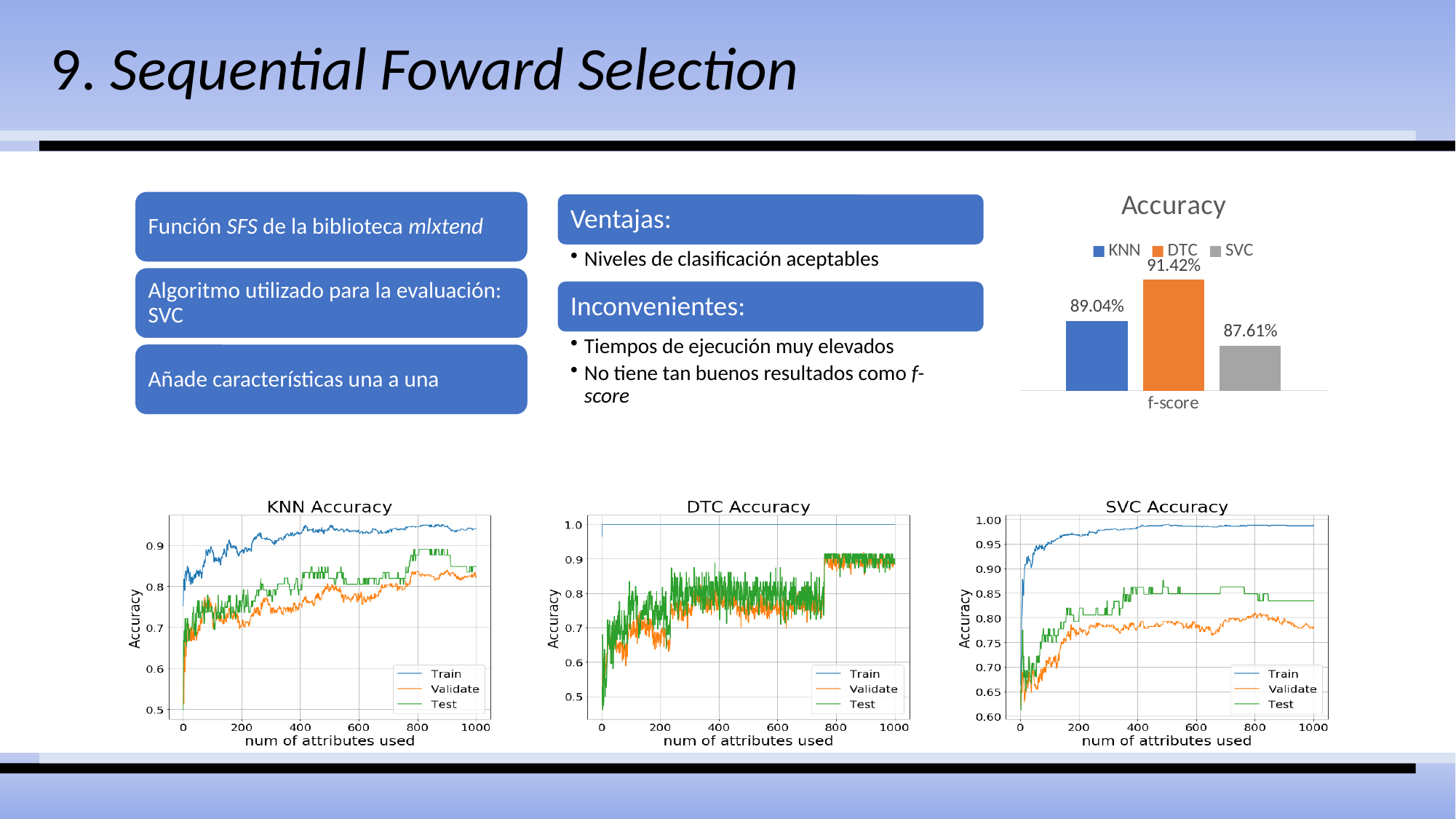
What kind of chart is the KNN Accuracy chart at the bottom left of the slide? Line chart In the Accuracy bar chart, which classifier has the highest value? DTC In the Accuracy bar chart, what is the value for SVC? 87.61% In the Accuracy bar chart, what is the value for KNN? 89.04% How many series does the legend of the Accuracy bar chart list? 3 How many series does the legend of the DTC Accuracy chart list? 3 In the Accuracy bar chart, what is the difference between the DTC and KNN values? 2.38% In the Accuracy bar chart, what is the value for DTC? 91.42% In the Accuracy bar chart, which is larger, the KNN value or the SVC value? KNN In the Accuracy bar chart, which classifier has the lowest value? SVC What kind of chart is the Accuracy chart at the top right of the slide? Bar chart In the SVC Accuracy chart, does the Train series generally rise or fall as the number of attributes used increases? Rise